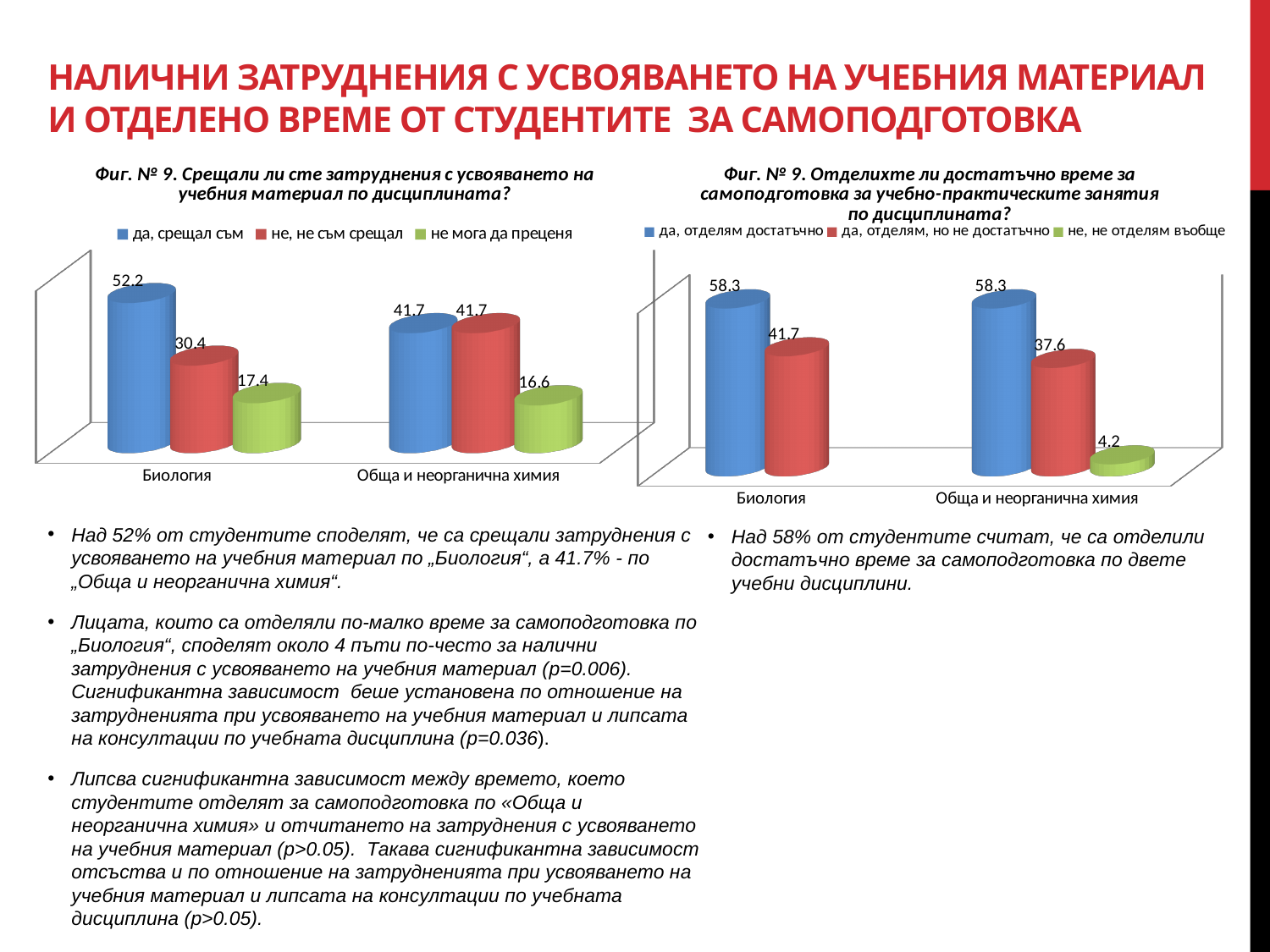
In the right chart, how many categories are shown on the x axis? 2 In the left chart, what is the difference between "да, срещал съм" and "не, не съм срещал" for Биология? 21.8 In the right chart, what is the value for "да, отделям, но не достатъчно" for Обща и неорганична химия? 37.6 In the right chart, which series has the highest value for Биология? да, отделям достатъчно In the left chart, what kind of chart is shown? Bar chart In the left chart, what is the value for "да, срещал съм" for Биология? 52.2 In the left chart, what is the value for "не мога да преценя" for Обща и неорганична химия? 16.6 In the right chart, what is the value for "не, не отделям въобще" for Обща и неорганична химия? 4.2 In the right chart, what is the difference between "да, отделям достатъчно" and "да, отделям, но не достатъчно" for Биология? 16.6 In the right chart, is the value for "да, отделям, но не достатъчно" larger for Биология or for Обща и неорганична химия? Биология In the left chart, which series has the lowest value for Биология? не мога да преценя In the left chart, how many series does the legend list? 3